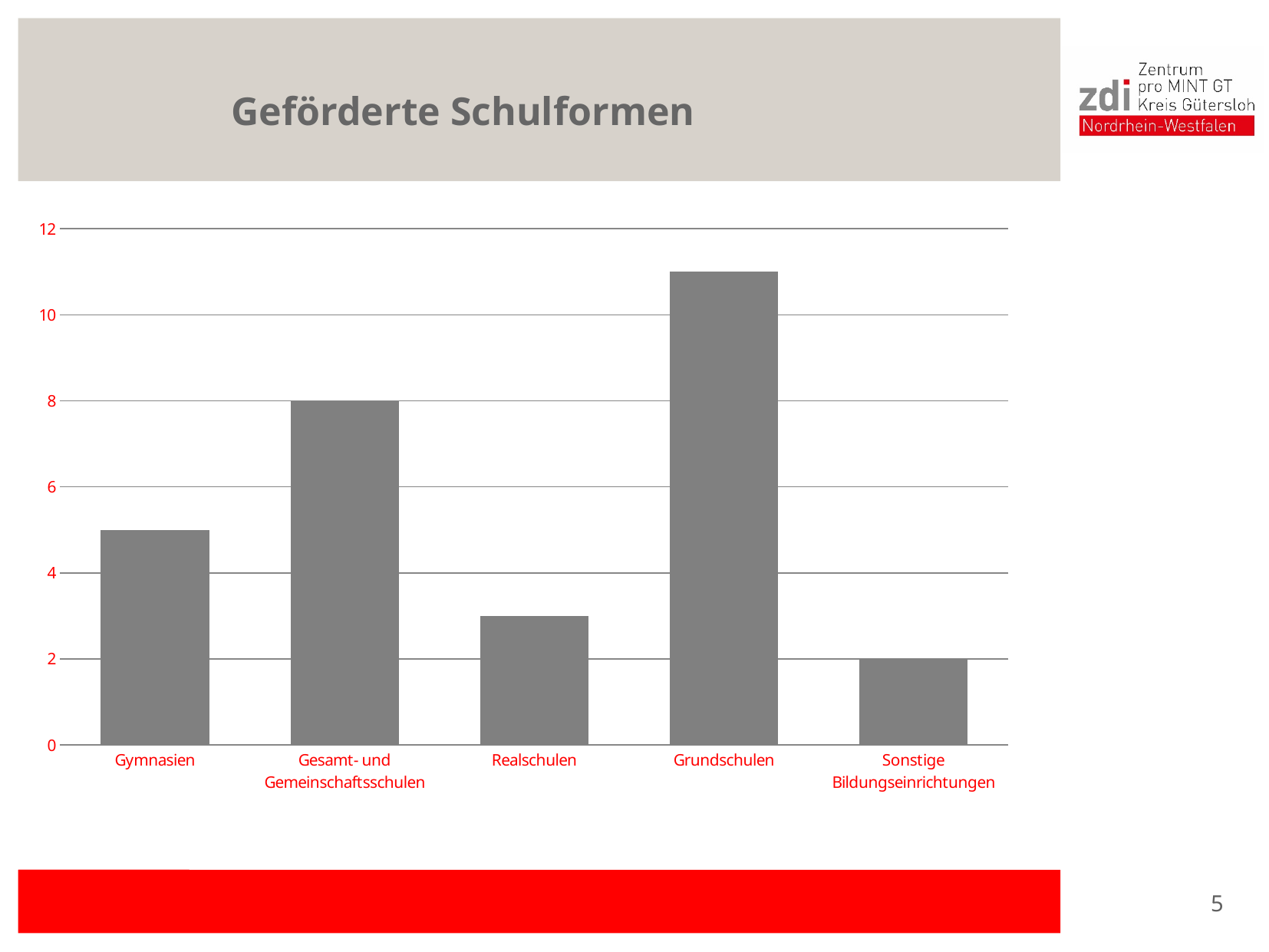
What is the title of the chart? Geförderte Schulformen Which category has the highest value? Grundschulen What is the difference between the values for Gesamt- und Gemeinschaftsschulen and Sonstige Bildungseinrichtungen? 6 How many school types (categories) are shown on the x axis? 5 Which category has the lowest value? Sonstige Bildungseinrichtungen What is the value for Sonstige Bildungseinrichtungen? 2 Is the value for Realschulen greater or less than 4? less What kind of chart is shown on the slide? bar chart What is the value for Gesamt- und Gemeinschaftsschulen? 8 Which is larger, the value for Gymnasien or the value for Realschulen? Gymnasien Is the value for Grundschulen greater or less than 10? greater Is the value for Gymnasien greater or less than 6? less